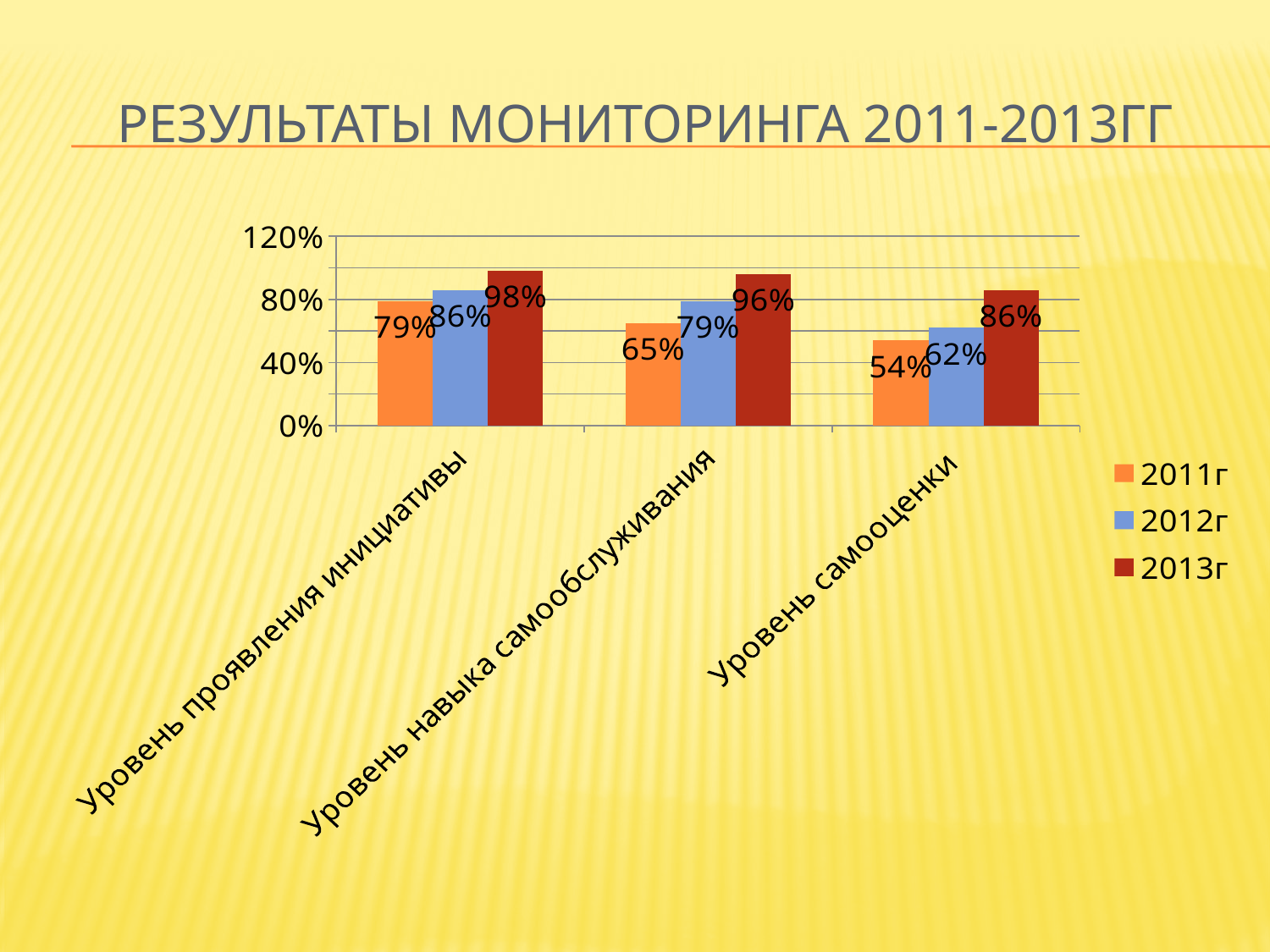
What is the value for 2011г in the category Уровень самооценки? 54% Which category has the lowest value for 2011г? Уровень самооценки What is the value for 2012г in the category Уровень навыка самообслуживания? 79% How many categories are shown on the x axis? 3 What is the title of the slide? РЕЗУЛЬТАТЫ МОНИТОРИНГА 2011-2013ГГ What kind of chart is shown on the slide? Bar chart Which is larger: the 2012г value for Уровень проявления инициативы or the 2012г value for Уровень самооценки? Уровень проявления инициативы How many series does the legend list? 3 What is the difference between the 2013г and 2011г values for Уровень самооценки? 32% Which category has the highest value for 2013г? Уровень проявления инициативы Within the category Уровень навыка самообслуживания, do the values rise or fall from 2011г to 2013г? Rise What is the value for 2013г in the category Уровень проявления инициативы? 98%